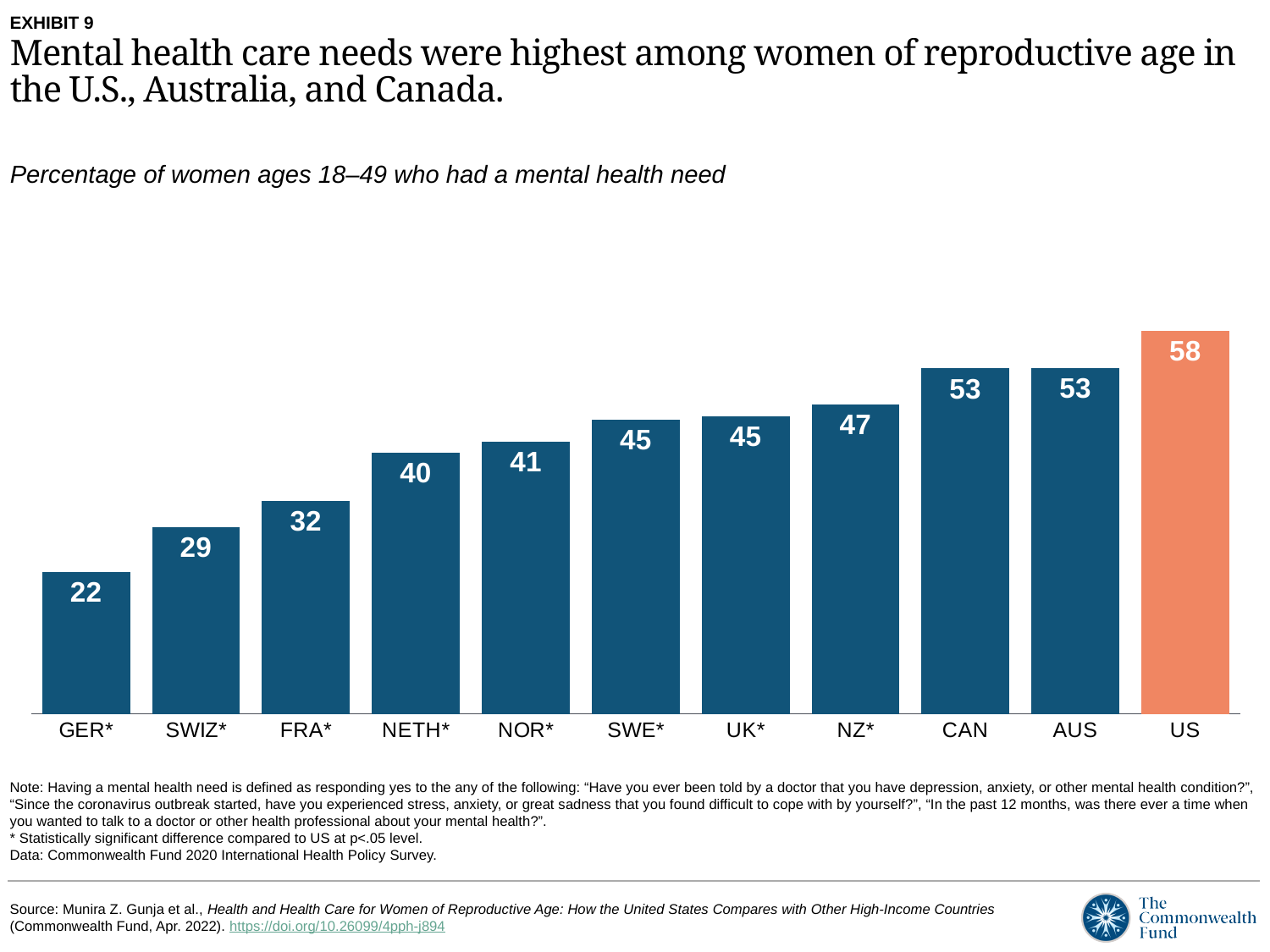
What is the difference between the values for NZ* and FRA*? 15 What is the value for GER*? 22 Which bar is shown in a different colour from the others? US Which country has the highest value? US What kind of chart is this? Bar chart Do the values rise or fall from left to right along the x axis? Rise What is the difference between the values for US and GER*? 36 Which is larger, the value for SWIZ* or the value for NOR*? NOR* Which country has the lowest value? GER* What is the value for NETH*? 40 How many countries are shown in the chart? 11 What is the value for US? 58